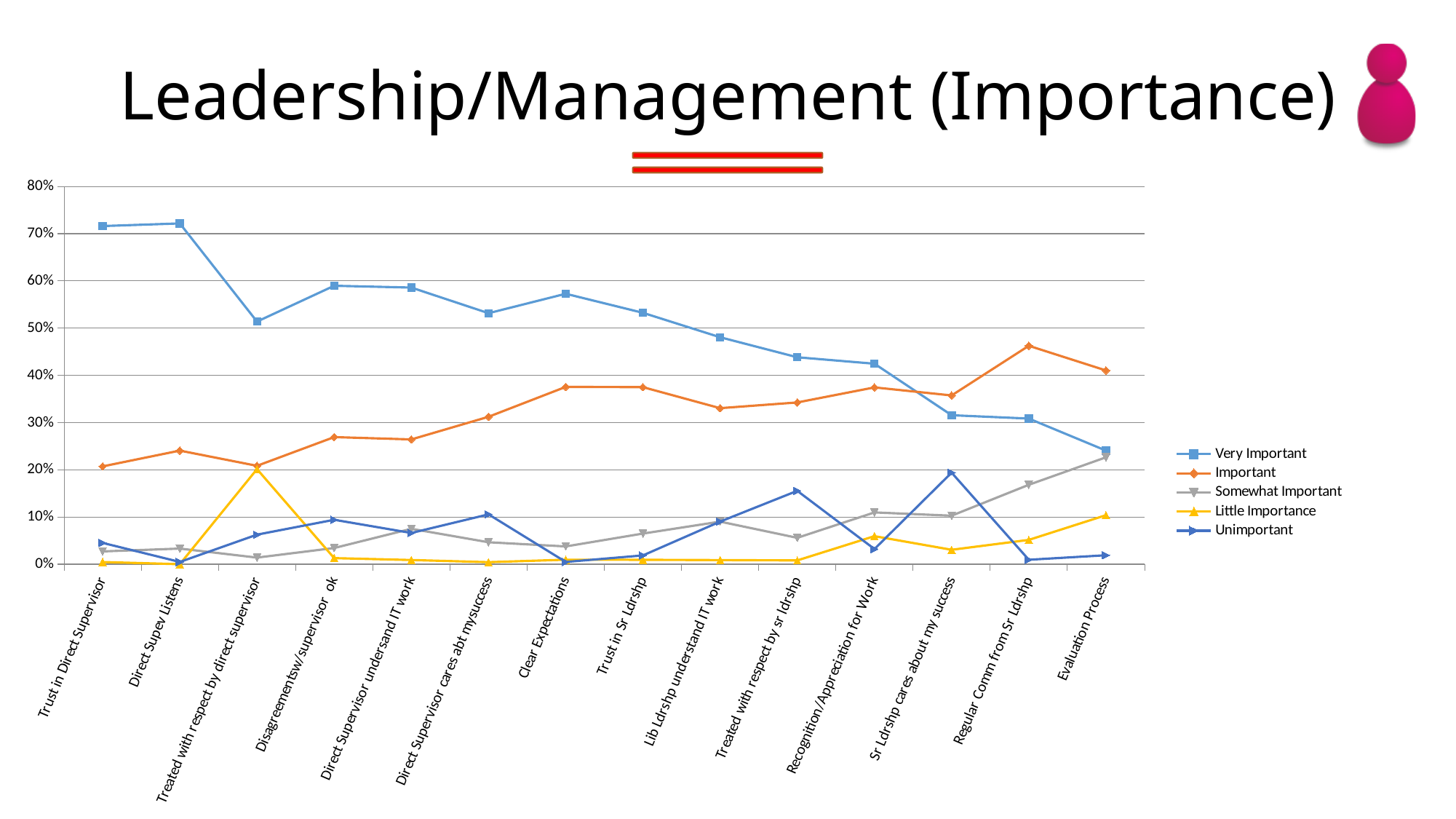
Does the Very Important series generally rise or fall from left to right across the x axis? Fall Which category has the highest value for the Somewhat Important series? Evaluation Process How many series does the legend list? 5 Which category has the highest value for the Important series? Regular Comm from Sr Ldrshp For Evaluation Process, which series has the larger value: Very Important or Important? Important Is the Very Important value for Clear Expectations greater or less than 50%? greater Is the Little Importance value for Treated with respect by direct supervisor greater or less than 10%? greater Which category has the highest value for the Little Importance series? Treated with respect by direct supervisor Is the Important value for Regular Comm from Sr Ldrshp greater or less than 40%? greater What kind of chart is shown on the slide? Line chart How many categories are plotted along the x axis? 14 Which category has the lowest value for the Very Important series? Evaluation Process